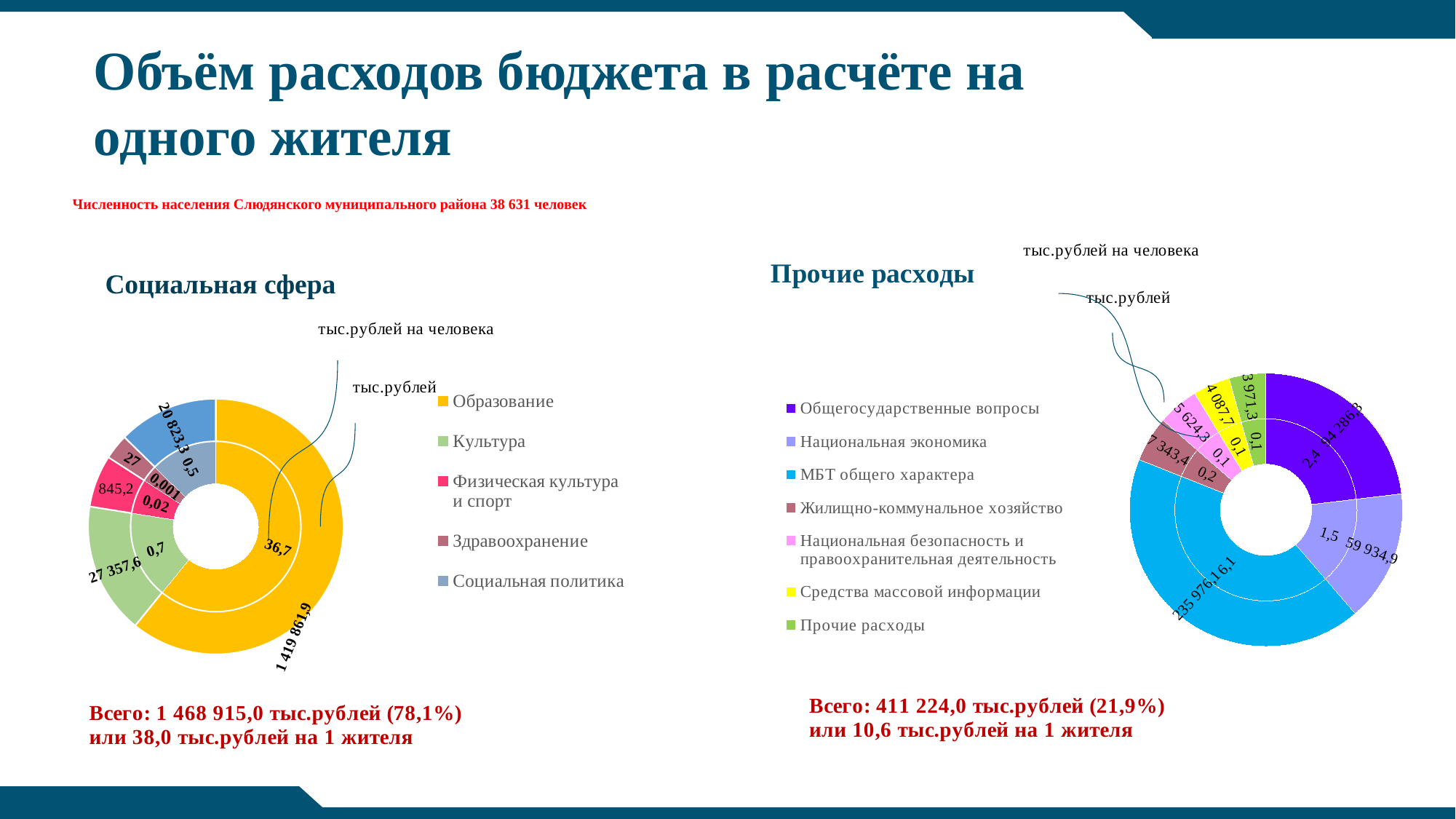
In the "Социальная сфера" chart, which category has the largest share? Образование In the "Прочие расходы" chart, what colour represents МБТ общего характера? light blue What kind of chart is used for the "Социальная сфера" chart? doughnut (pie) chart In the "Социальная сфера" chart, what is the value in тыс.рублей for Культура? 27 357,6 In the "Прочие расходы" chart, what is the value in тыс.рублей на человека for Общегосударственные вопросы? 2,4 In the "Социальная сфера" chart, what is the value in тыс.рублей for Образование? 1 419 861,9 How many categories does the legend of the "Прочие расходы" chart list? 7 In the "Социальная сфера" chart, which category has the smallest value in тыс.рублей? Здравоохранение In the "Социальная сфера" chart, what is the value in тыс.рублей на человека for Образование? 36,7 In the "Прочие расходы" chart, what is the value in тыс.рублей for МБТ общего характера? 235 976,1 How many categories does the legend of the "Социальная сфера" chart list? 5 In the "Прочие расходы" chart, which is larger in тыс.рублей: Общегосударственные вопросы or Национальная экономика? Общегосударственные вопросы